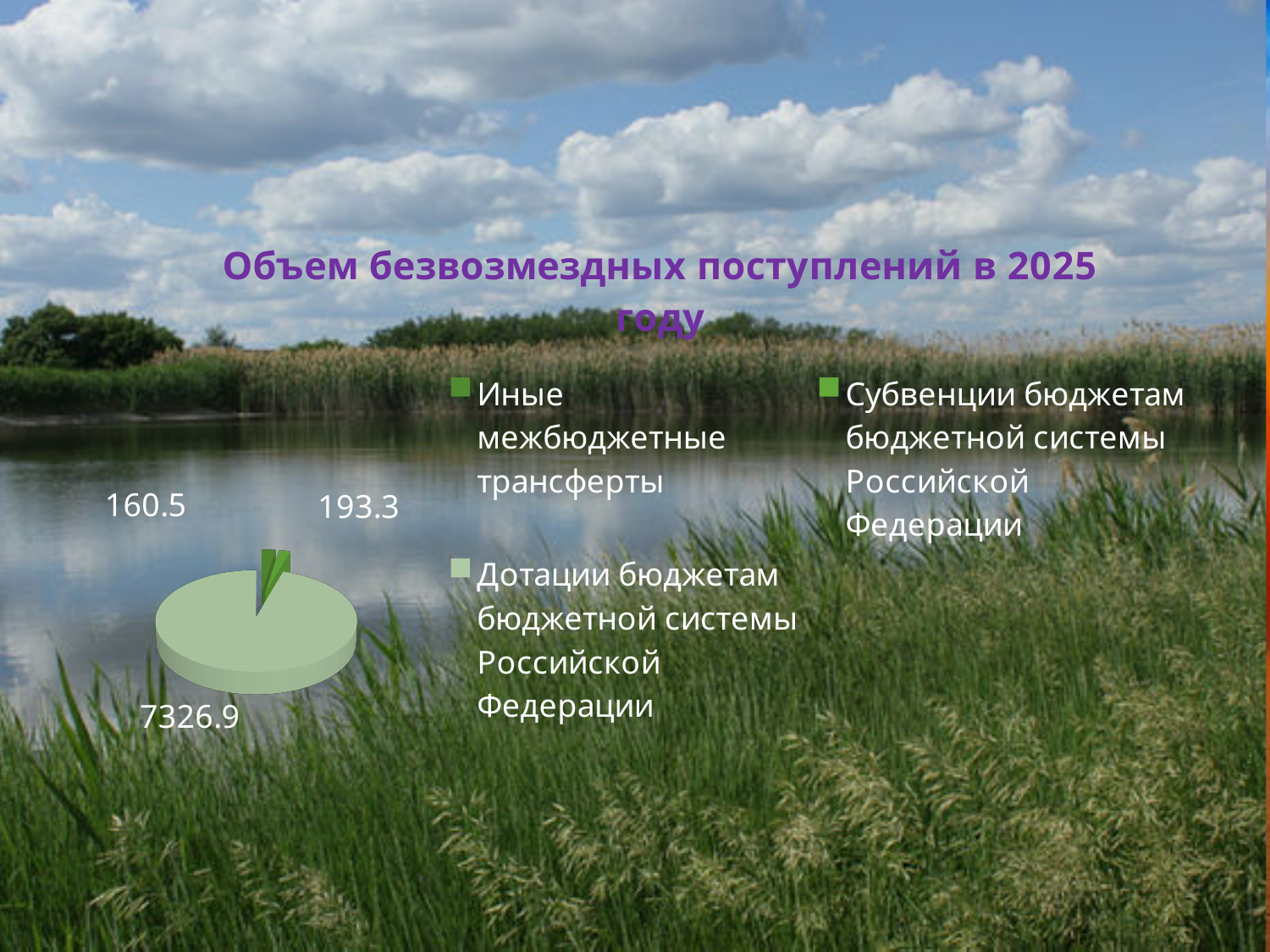
What is the title of the chart? Объем безвозмездных поступлений в 2025 году What kind of chart is shown on the slide? pie chart What is the total of all values shown on the pie chart? 7680.7 What is the value for Дотации бюджетам бюджетной системы Российской Федерации? 7326.9 Which category has the largest slice of the pie? Дотации бюджетам бюджетной системы Российской Федерации What is the difference between the two smallest values, 193.3 and 160.5? 32.8 What is the difference between the largest value (7326.9) and the value 193.3? 7133.6 How many slices does the pie chart have? 3 Is the value for Дотации бюджетам бюджетной системы Российской Федерации larger than the value 193.3? yes How many entries does the legend list? 3 What is the smallest value shown on the pie chart? 160.5